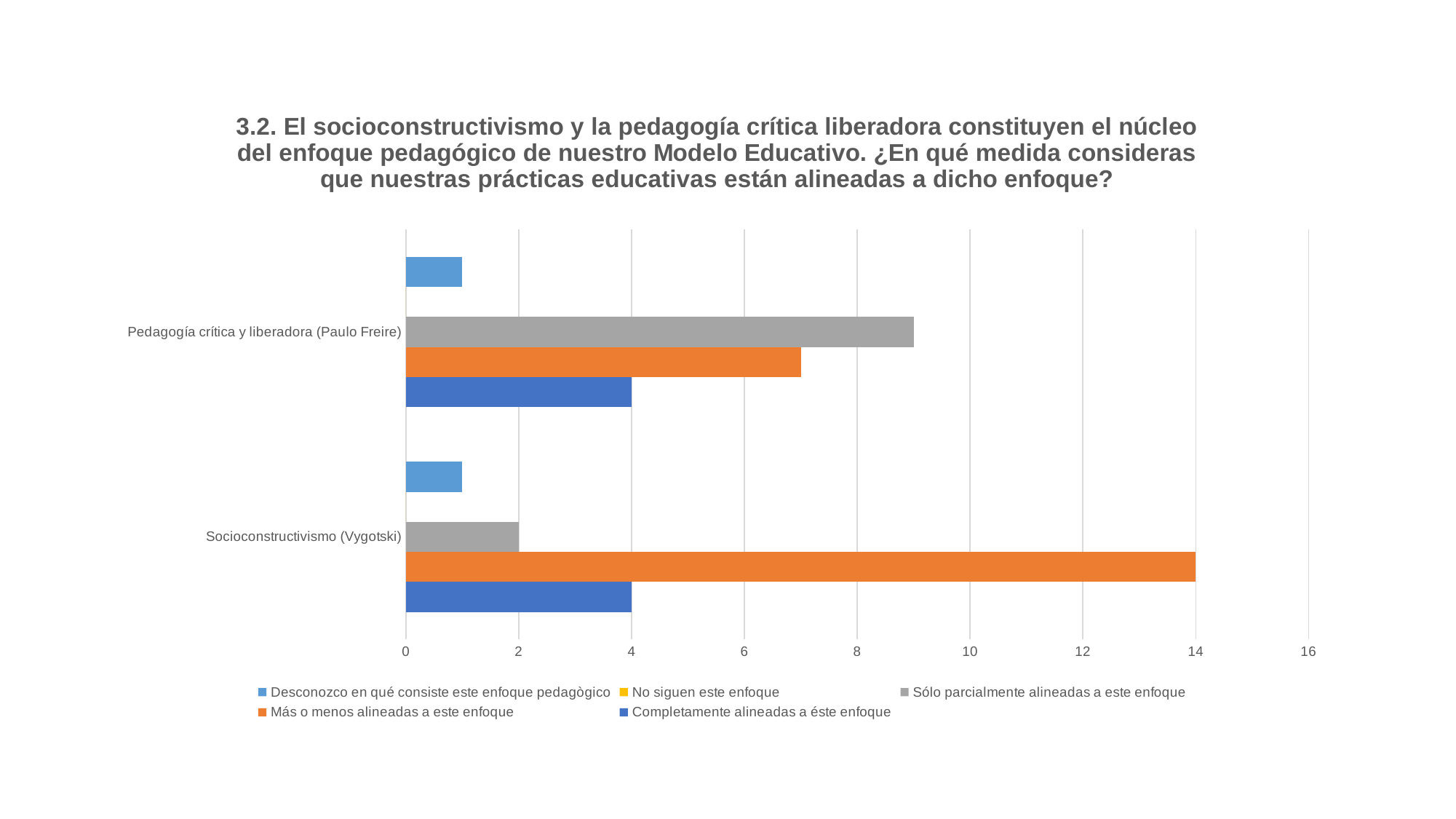
Which response has the highest value for Socioconstructivismo (Vygotski)? Más o menos alineadas a este enfoque What is the value for 'Sólo parcialmente alineadas a este enfoque' for Socioconstructivismo (Vygotski)? 2 Which response has the highest value for Pedagogía crítica y liberadora (Paulo Freire)? Sólo parcialmente alineadas a este enfoque How many categories (pedagogical approaches) are plotted on the chart? 2 Is the value for 'Sólo parcialmente alineadas a este enfoque' for Pedagogía crítica y liberadora (Paulo Freire) greater or less than 8? greater How many series does the legend list? 5 For Socioconstructivismo (Vygotski), what is the difference between 'Más o menos alineadas a este enfoque' and 'Completamente alineadas a éste enfoque'? 10 What is the value for 'Más o menos alineadas a este enfoque' for Socioconstructivismo (Vygotski)? 14 What is the value for 'Completamente alineadas a éste enfoque' for Pedagogía crítica y liberadora (Paulo Freire)? 4 Which category has the larger value for 'Más o menos alineadas a este enfoque': Pedagogía crítica y liberadora (Paulo Freire) or Socioconstructivismo (Vygotski)? Socioconstructivismo (Vygotski) What is the value for 'Completamente alineadas a éste enfoque' for Socioconstructivismo (Vygotski)? 4 What kind of chart is shown on the slide? bar chart